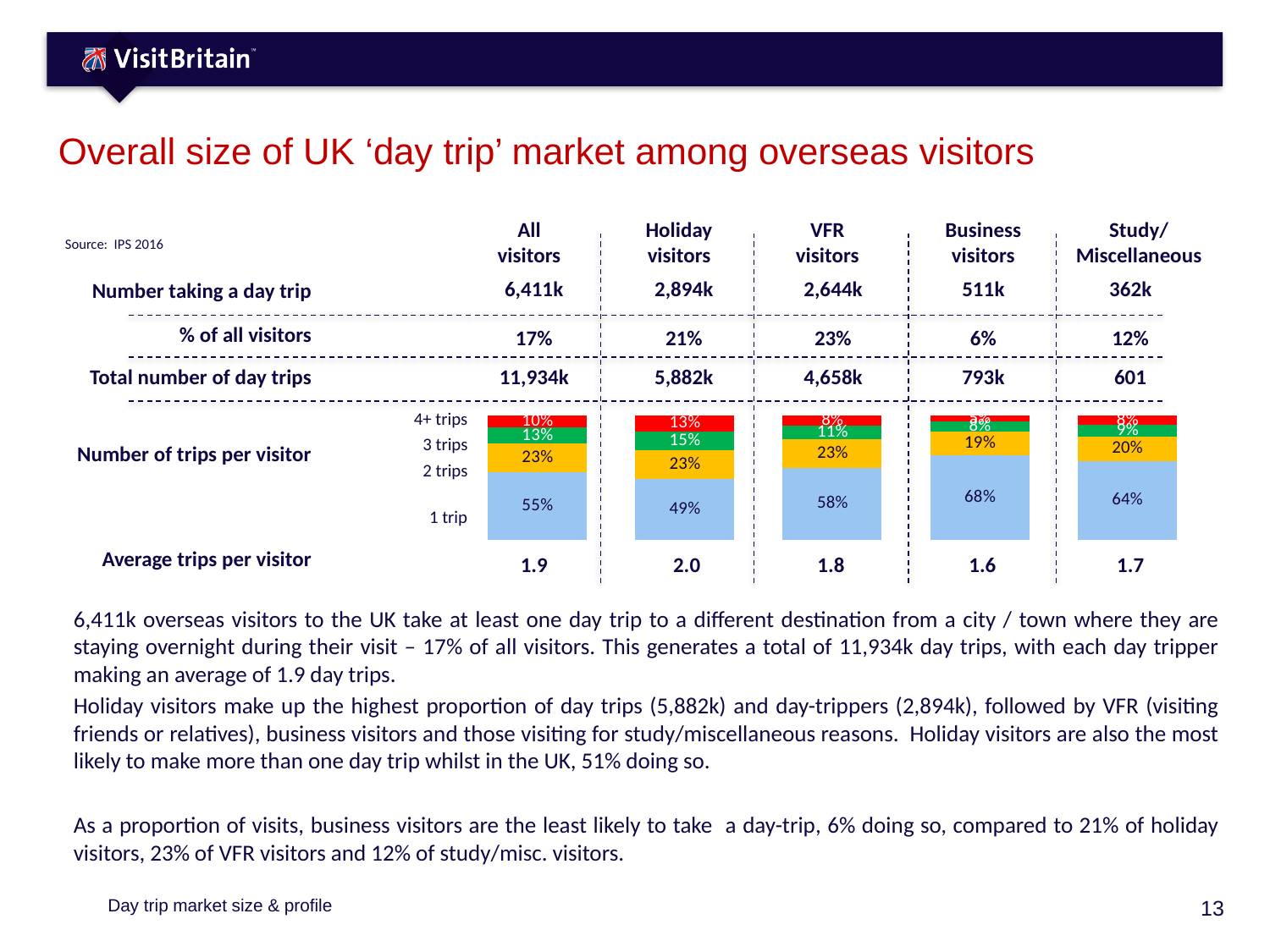
In the 'Number of trips per visitor' chart for Holiday visitors, what share take 4+ trips? 13% In the 'Number of trips per visitor' chart for All visitors, what share of day trippers take 1 trip? 55% Across the 'Number of trips per visitor' charts, which visitor type has the lowest share taking only 1 trip? Holiday visitors In the 'Number of trips per visitor' chart for Holiday visitors, what share take 1 trip? 49% In the 'Number of trips per visitor' charts, is the 2-trips share larger for All visitors or for Study/Miscellaneous visitors? All visitors In the 'Number of trips per visitor' charts, what is the difference between the 1-trip share for Business visitors and for Holiday visitors? 19 percentage points In the 'Number of trips per visitor' chart for Business visitors, what share take 1 trip? 68% Across the 'Number of trips per visitor' charts, which visitor type has the highest share taking only 1 trip? Business visitors How many segments (trip categories) does each 'Number of trips per visitor' bar contain? 4 In the 'Number of trips per visitor' chart for Study/Miscellaneous visitors, what share take 2 trips? 20% In the 'Number of trips per visitor' chart for VFR visitors, what share take 3 trips? 11% What kind of chart is used to show 'Number of trips per visitor'? Stacked bar chart